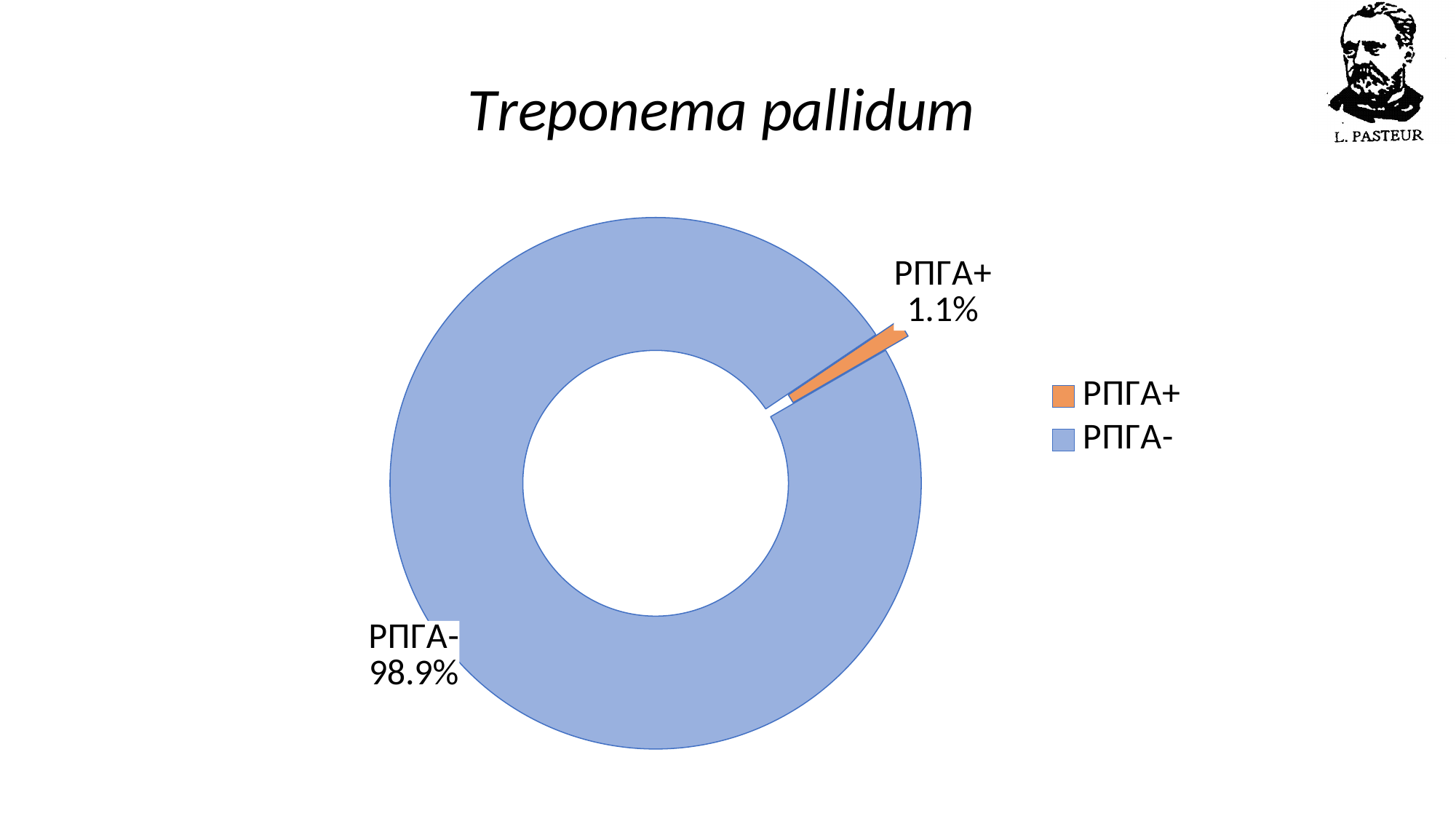
Which category has the largest share of the chart? РПГА- What colour is the РПГА+ slice? Orange Which category has the smallest share of the chart? РПГА+ What is the title of the slide? Treponema pallidum What share of the pie does the РПГА+ slice represent? 1.1% What percentage is shown for РПГА-? 98.9% How many entries does the legend list? 2 What percentage is shown for РПГА+? 1.1% Which is larger, the share for РПГА+ or the share for РПГА-? РПГА- What is the difference in percentage points between РПГА- and РПГА+? 97.8 How many categories does the chart show? 2 What kind of chart is shown on the slide? Pie chart (doughnut)